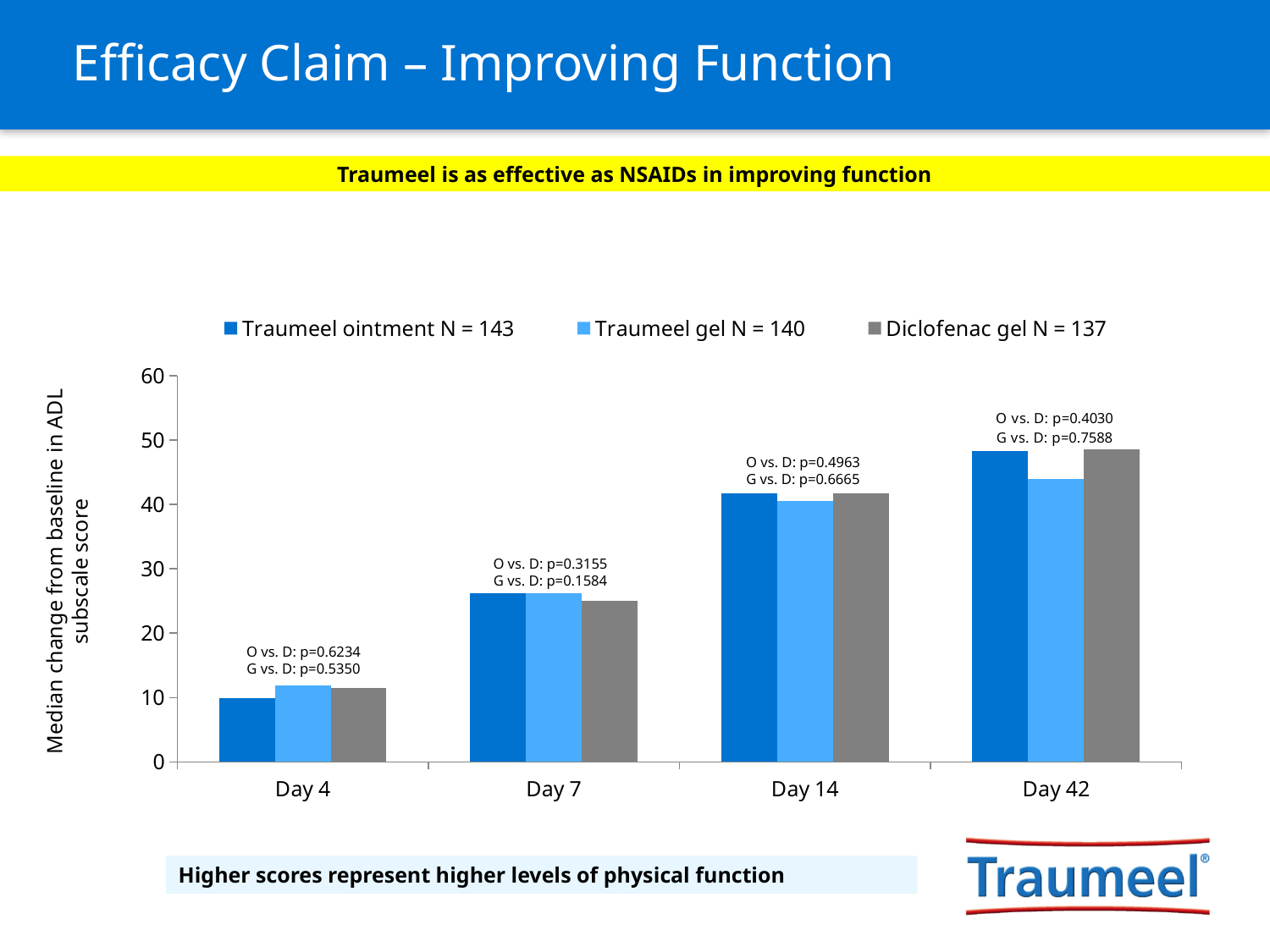
At which day is the Traumeel gel value lowest? Day 4 What kind of chart is shown on the slide? bar chart Is the value for Traumeel ointment at Day 42 greater or less than 50? less What is the p-value shown for O vs. D at Day 7? p=0.3155 At Day 42, which is larger: the Traumeel gel value or the Diclofenac gel value? Diclofenac gel Is the value for Traumeel ointment at Day 4 greater or less than 20? less At which day is the Diclofenac gel value highest? Day 42 How many series does the legend list? 3 Do the Traumeel ointment values rise or fall from Day 4 to Day 42? rise What is the label on the y axis? Median change from baseline in ADL subscale score How many time points (categories) are shown on the x axis? 4 Is the value for Diclofenac gel at Day 14 greater or less than 30? greater